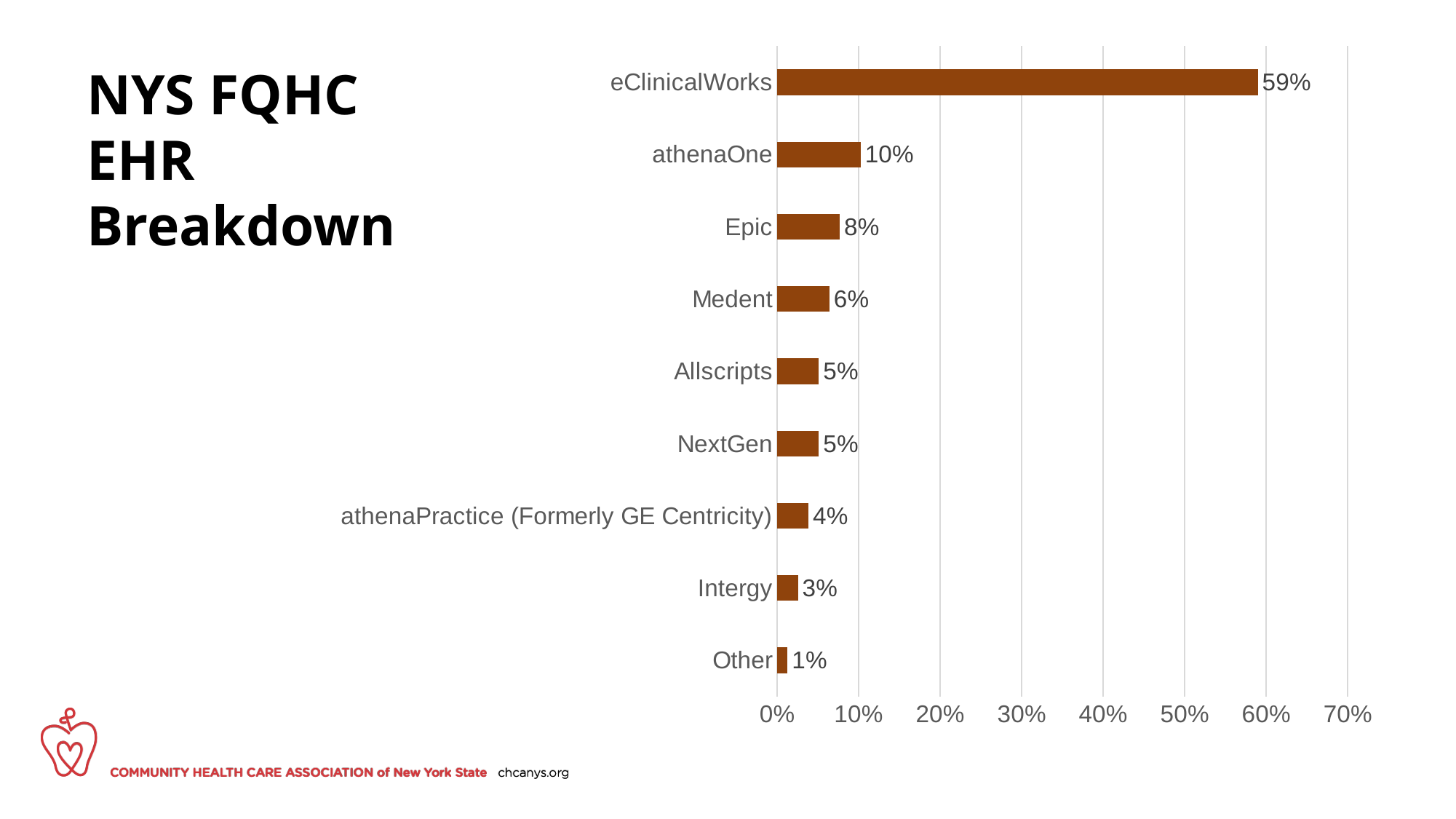
What is the value for Intergy? 3% What is the difference between the values for Epic and Medent? 2% What kind of chart is shown on the slide? Bar chart What is the value for athenaPractice (Formerly GE Centricity)? 4% Which category has the lowest value? Other Which is larger, the value for Epic or the value for Medent? Epic What is the difference between the values for eClinicalWorks and athenaOne? 49% What is the title of the slide? NYS FQHC EHR Breakdown What is the value for eClinicalWorks? 59% What is the value for athenaOne? 10% Which category has the highest value? eClinicalWorks How many categories are shown in the chart? 9